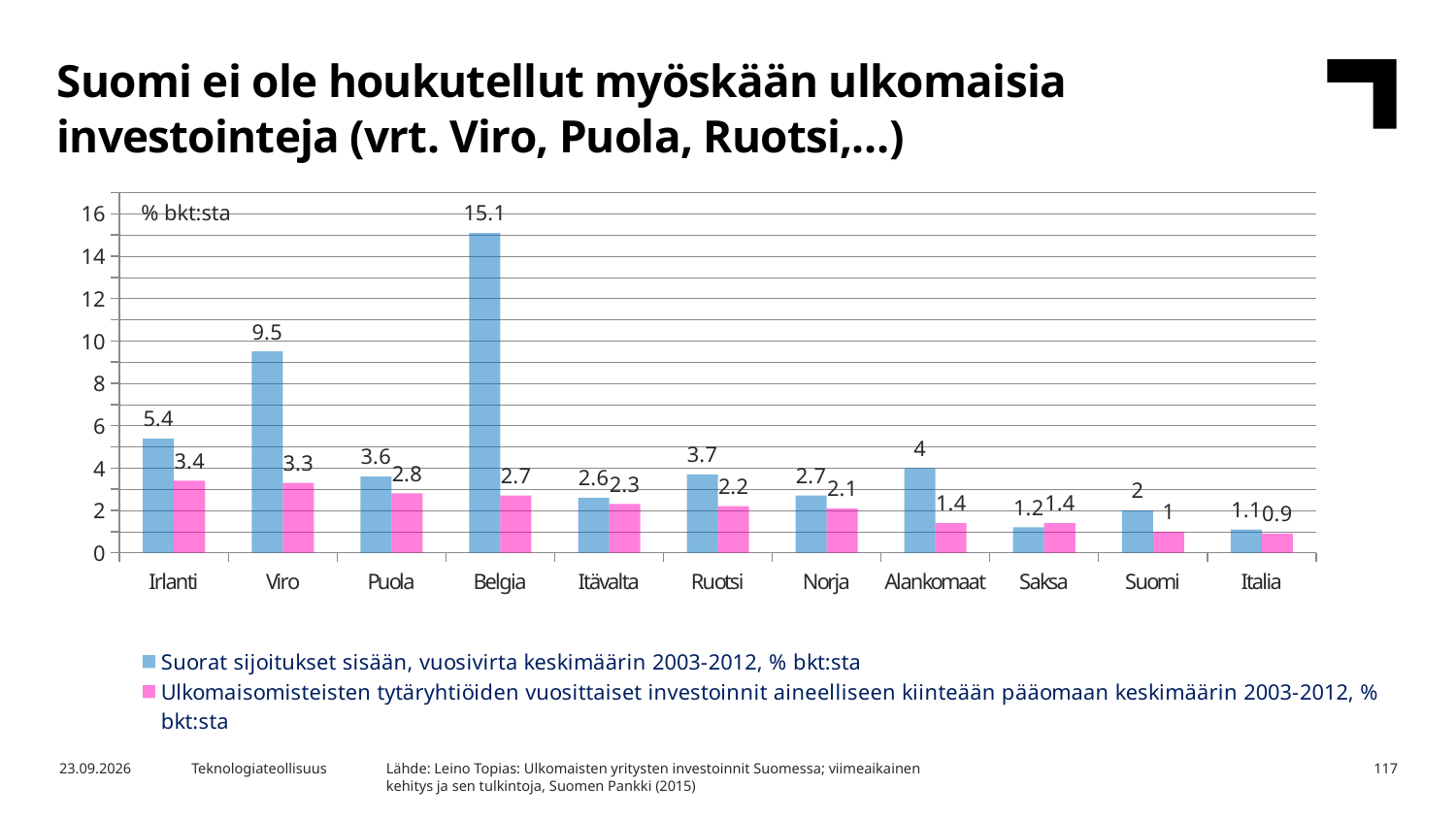
How many countries are shown on the x axis? 11 What is the difference between the blue series values for Belgia and Viro? 5.6 What kind of chart is shown on the slide? Bar chart Which is larger: the blue series value for Suomi or the blue series value for Ruotsi? Ruotsi Which country has the highest value in the blue series (Suorat sijoitukset sisään)? Belgia What is the difference between the blue and pink series values for Irlanti? 2 What is the value of the blue series (Suorat sijoitukset sisään) for Viro? 9.5 What is the value of the pink series (Ulkomaisomisteisten tytäryhtiöiden vuosittaiset investoinnit) for Suomi? 1 Which country has the lowest value in the pink series (Ulkomaisomisteisten tytäryhtiöiden vuosittaiset investoinnit)? Italia How many series does the legend list? 2 What unit label is shown at the top of the y axis? % bkt:sta What is the value of the blue series (Suorat sijoitukset sisään) for Belgia? 15.1